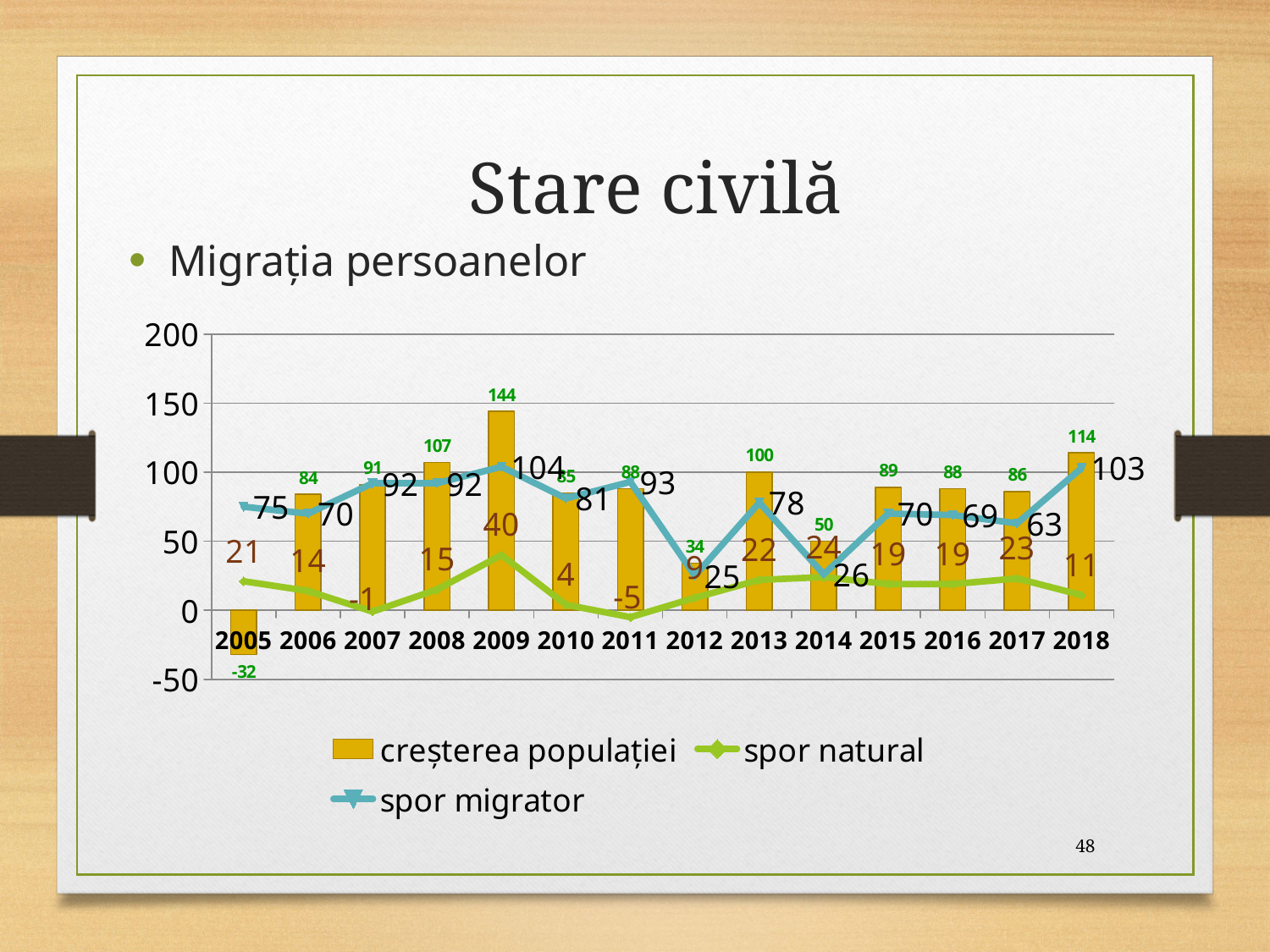
Which year has the lowest value for creșterea populației? 2005 Which is larger, spor migrator in 2013 or spor migrator in 2014? 2013 What is the difference between creșterea populației in 2018 and in 2017? 28 What kind of chart is shown on the slide? Combined bar and line chart How many series does the legend list? 3 Which series is drawn as bars? creșterea populației What is the value of spor natural for 2011? -5 What is the value of spor migrator for 2018? 103 How many years are shown on the x axis? 14 Which year has the lowest value for spor migrator? 2012 Which year has the highest value for creșterea populației? 2009 What is the value of creșterea populației for 2009? 144